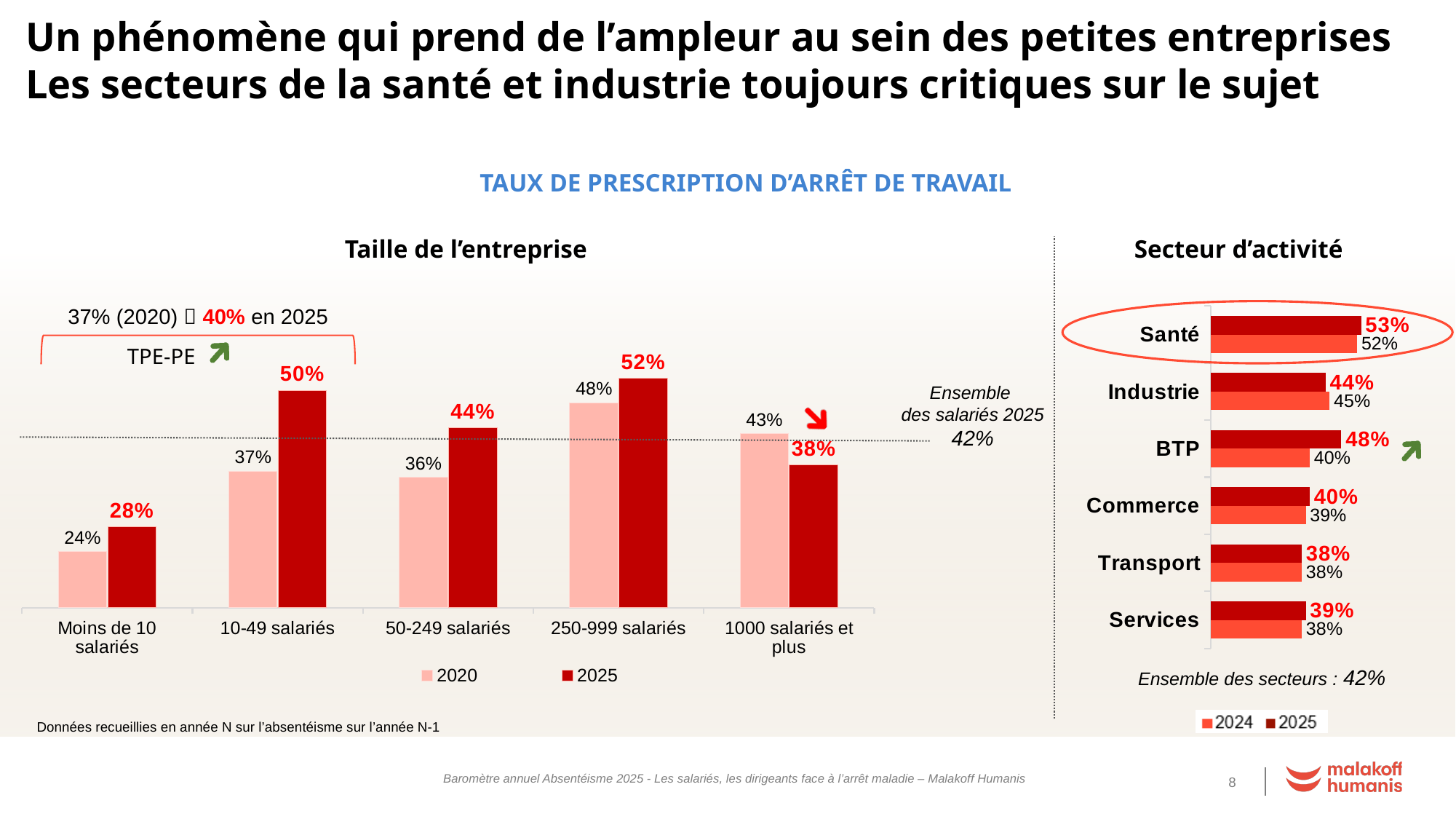
In the 'Taille de l'entreprise' chart, what is the difference between the 2025 and 2020 values for 10-49 salariés? 13 percentage points In the 'Secteur d'activité' chart, what is the 2025 value for BTP? 48% In the 'Secteur d'activité' chart, which sector has the highest 2025 value? Santé In the 'Secteur d'activité' chart, what is the difference between the 2025 and 2024 values for BTP? 8 percentage points How many categories does the 'Taille de l'entreprise' chart show? 5 In the 'Taille de l'entreprise' chart, what is the 2025 value for 10-49 salariés? 50% In the 'Taille de l'entreprise' chart, which category has the highest 2025 value? 250-999 salariés In the 'Taille de l'entreprise' chart, what is the 2020 value for 1000 salariés et plus? 43% In the 'Taille de l'entreprise' chart, is the 2020 or the 2025 value larger for 1000 salariés et plus? 2020 Which two series does the legend of the 'Secteur d'activité' chart list? 2024 and 2025 In the 'Taille de l'entreprise' chart, which category has the lowest 2025 value? Moins de 10 salariés What type of chart is the 'Secteur d'activité' chart? Bar chart